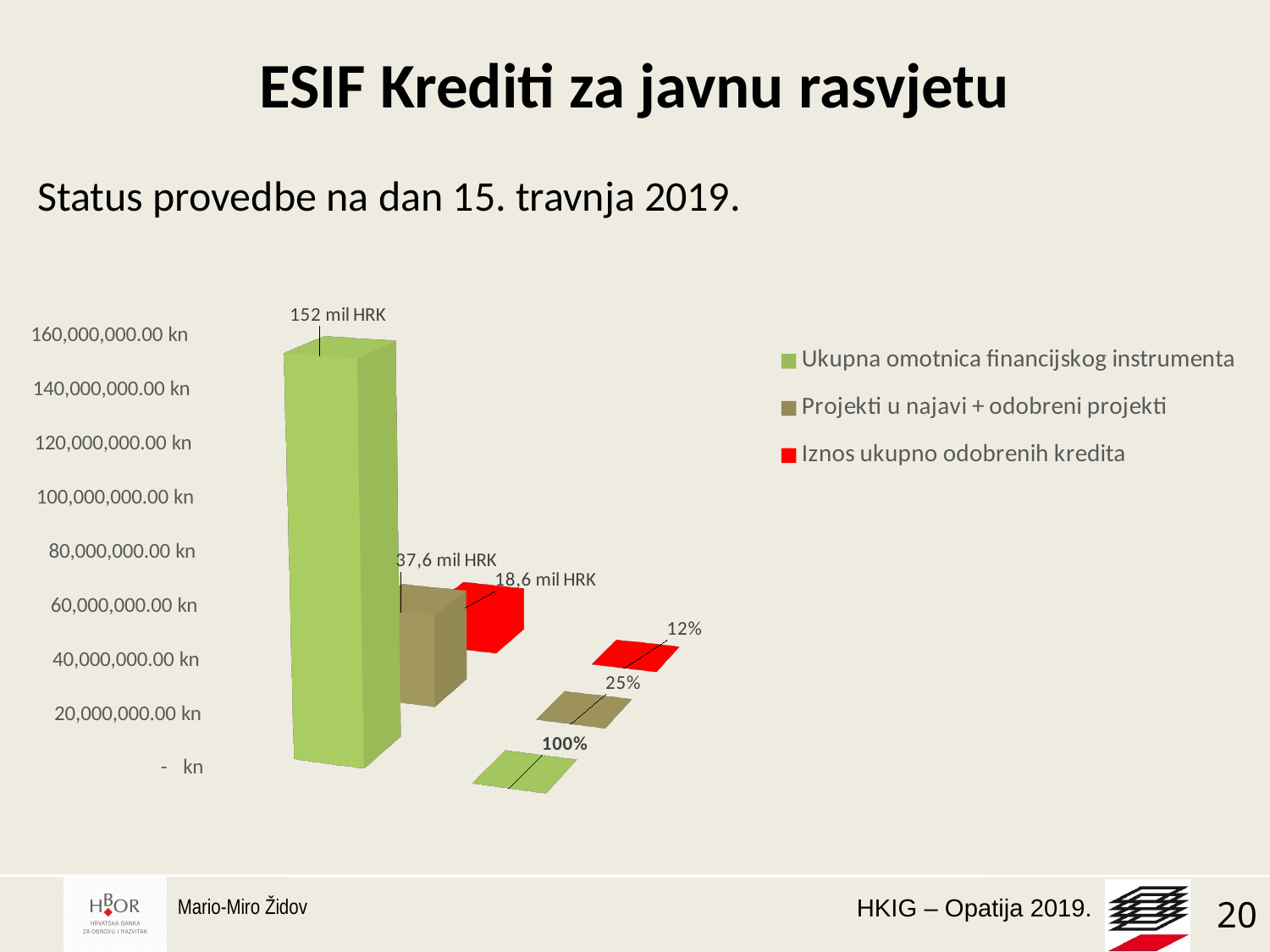
What percentage is shown for Projekti u najavi + odobreni projekti? 25% What is the difference between the values for Projekti u najavi + odobreni projekti and Iznos ukupno odobrenih kredita? 19 mil HRK What value is labelled on the red bar for Iznos ukupno odobrenih kredita? 18,6 mil HRK What kind of chart is shown on the slide? bar chart What value is labelled on the green bar for Ukupna omotnica financijskog instrumenta? 152 mil HRK Is the value for Ukupna omotnica financijskog instrumenta greater or less than 140,000,000.00 kn? greater Which series has the lowest value in the chart? Iznos ukupno odobrenih kredita What percentage is shown for Iznos ukupno odobrenih kredita? 12% How many series does the legend list? 3 Which series has the highest value in the chart? Ukupna omotnica financijskog instrumenta Which is larger: the value for Projekti u najavi + odobreni projekti or the value for Iznos ukupno odobrenih kredita? Projekti u najavi + odobreni projekti What value is labelled on the bar for Projekti u najavi + odobreni projekti? 37,6 mil HRK